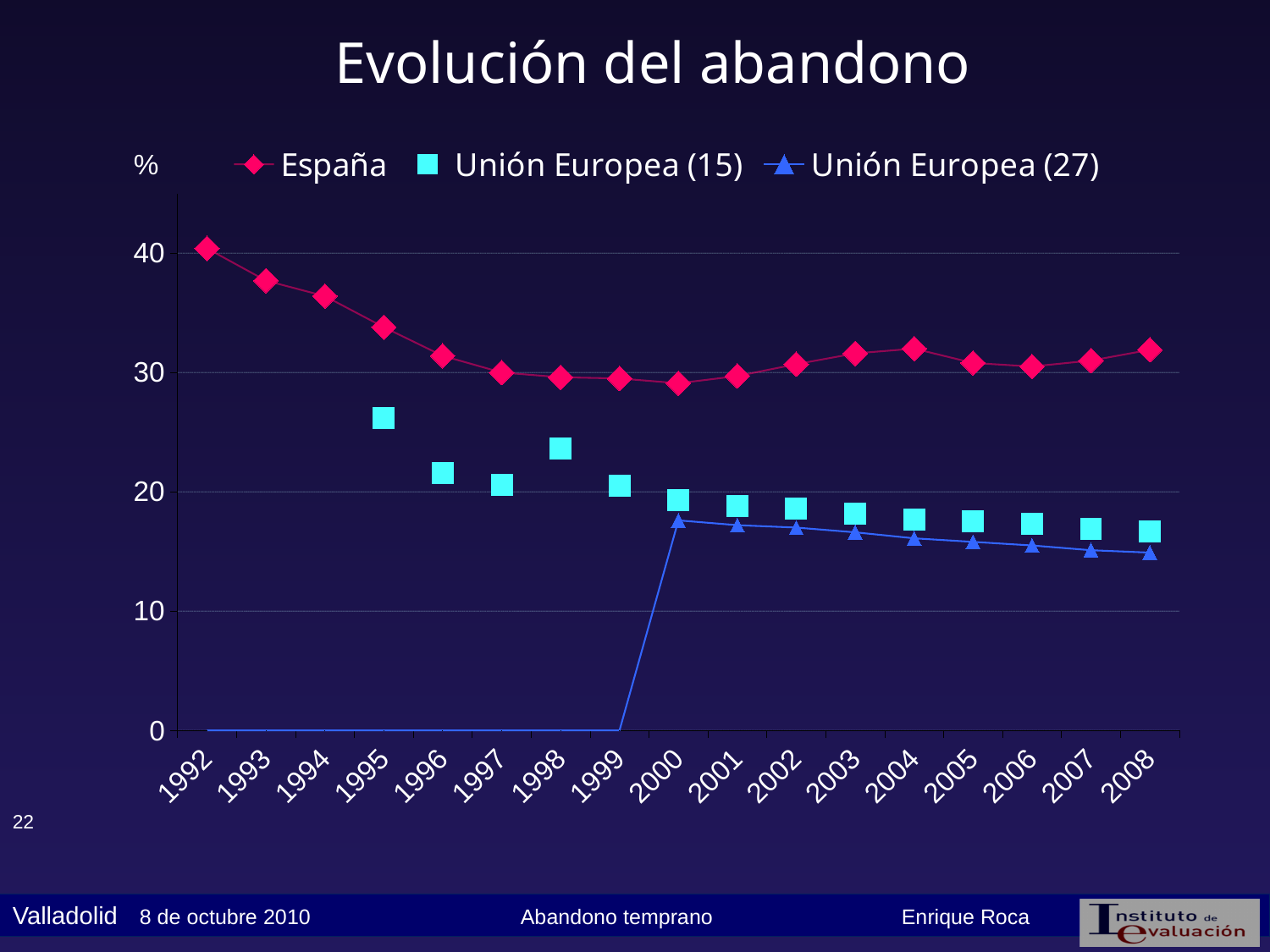
Do the values for Unión Europea (27) rise or fall from 2000 to 2008? fall Is the value for Unión Europea (27) in 2008 greater or less than 20? less How many series does the legend list? 3 How many years are shown on the x axis? 17 What kind of chart is shown on the slide? line chart Which is larger in 2004, the value for Unión Europea (15) or the value for Unión Europea (27)? Unión Europea (15) Is the value for Unión Europea (15) in 1995 greater or less than 20? greater Which year has the highest value for España? 1992 Which is larger in 2008, the value for España or the value for Unión Europea (15)? España What is the title of the chart? Evolución del abandono Is the value for España in 1992 greater or less than 30? greater